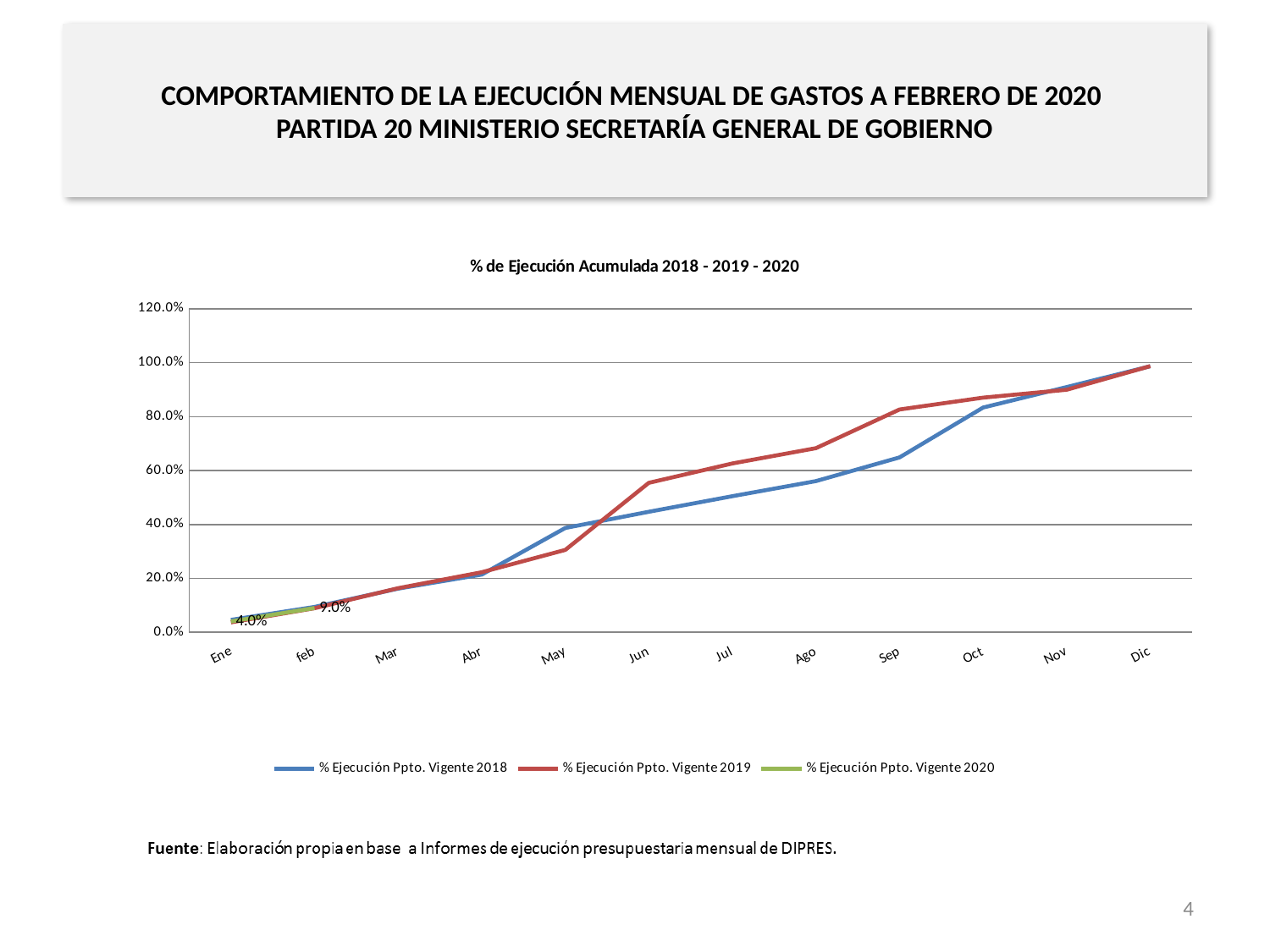
Is the value for % Ejecución Ppto. Vigente 2019 in Jun greater or less than 40.0%? greater In Sep, which series is higher: % Ejecución Ppto. Vigente 2018 or % Ejecución Ppto. Vigente 2019? % Ejecución Ppto. Vigente 2019 What is the title of the chart? % de Ejecución Acumulada 2018 - 2019 - 2020 Do the values of % Ejecución Ppto. Vigente 2018 rise or fall from Ene to Dic? Rise What is the value of % Ejecución Ppto. Vigente 2020 in Feb? 9.0% What kind of chart is shown on the slide? Line chart In May, which series is higher: % Ejecución Ppto. Vigente 2018 or % Ejecución Ppto. Vigente 2019? % Ejecución Ppto. Vigente 2018 What is the value of % Ejecución Ppto. Vigente 2020 in Ene? 4.0% Is the value for % Ejecución Ppto. Vigente 2018 in Sep greater or less than 80.0%? less By how much did % Ejecución Ppto. Vigente 2020 increase from Ene to Feb? 5.0% How many series does the legend list? 3 How many months are shown along the x axis? 12